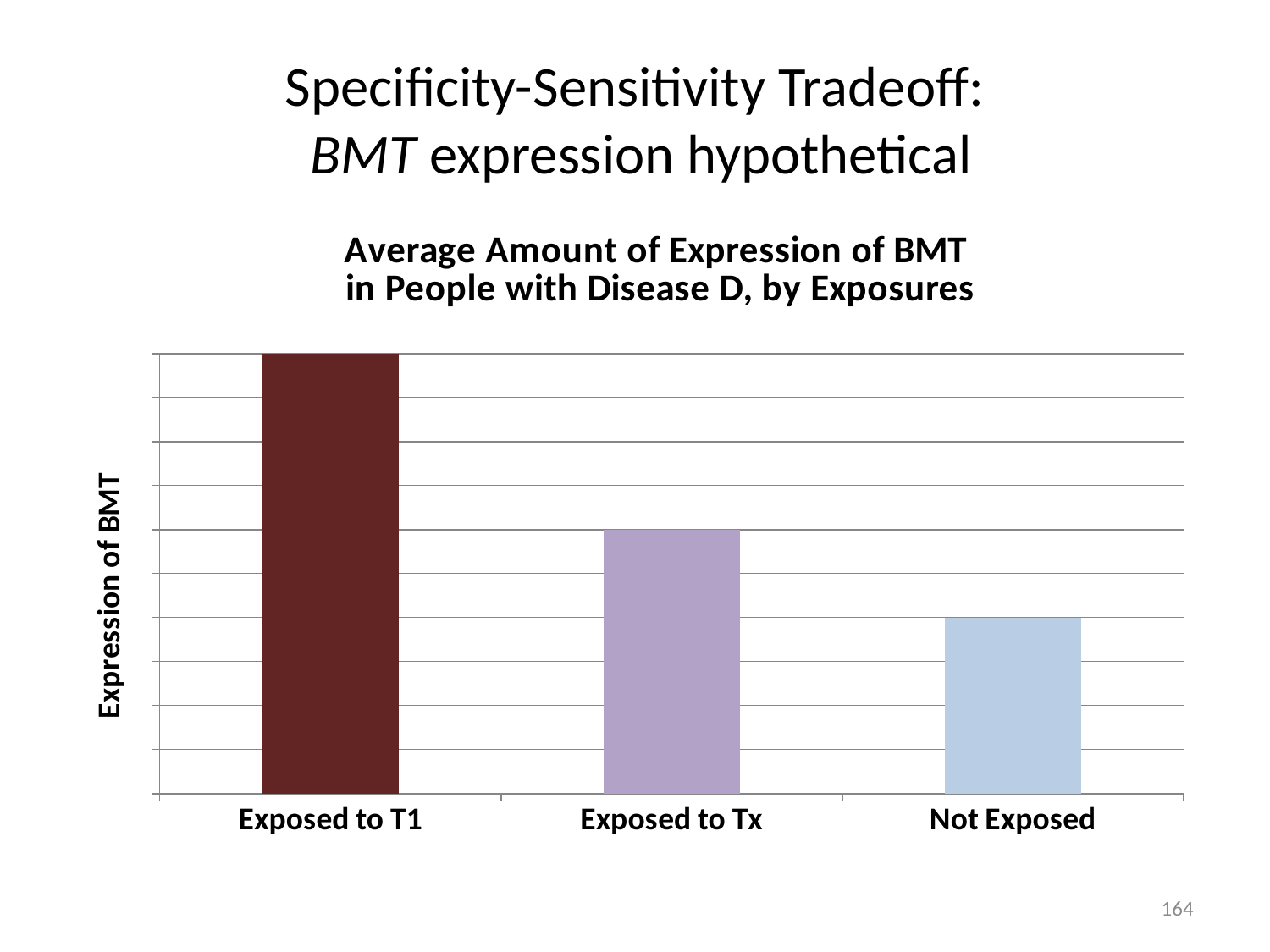
What is the label on the vertical axis of the chart? Expression of BMT Which exposure group has the lowest average expression of BMT? Not Exposed Which exposure group has the highest average expression of BMT? Exposed to T1 Do the bar values rise or fall moving from left to right across the categories? fall Which has a higher expression of BMT: Exposed to Tx or Not Exposed? Exposed to Tx Which has a higher expression of BMT: Exposed to T1 or Exposed to Tx? Exposed to T1 What is the title of the chart? Average Amount of Expression of BMT in People with Disease D, by Exposures What type of chart is shown on the slide? bar chart How many exposure categories are plotted in the chart? 3